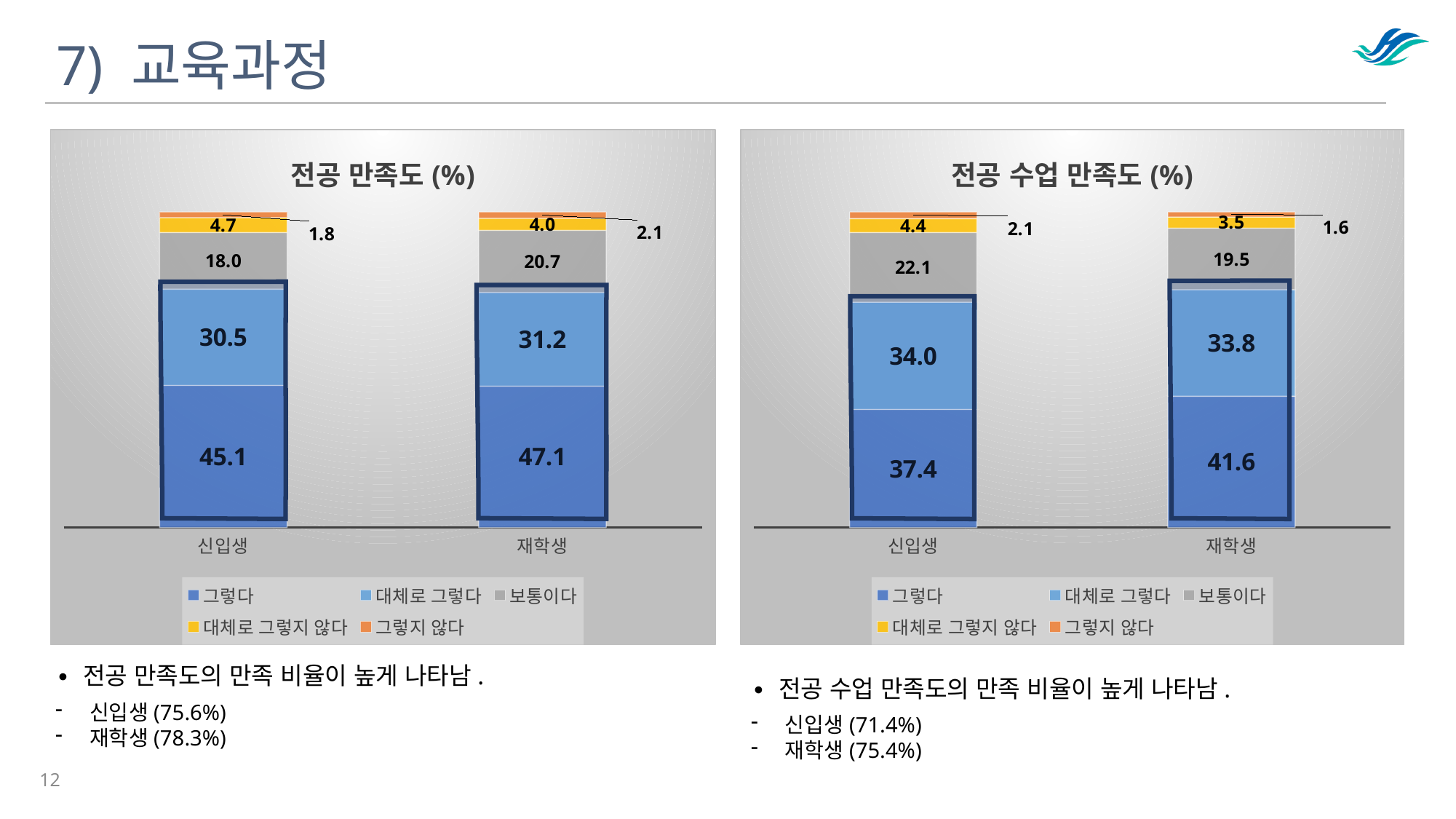
In the 전공 만족도 (%) chart, what is the value of 그렇다 for 신입생? 45.1 In the 전공 수업 만족도 (%) chart, which category has the higher 보통이다 value, 신입생 or 재학생? 신입생 In the 전공 수업 만족도 (%) chart, what is the value of 그렇지 않다 for 재학생? 1.6 How many categories are shown on the x axis of the 전공 만족도 (%) chart? 2 In the 전공 만족도 (%) chart, which category has the higher 그렇다 value, 신입생 or 재학생? 재학생 In the 전공 만족도 (%) chart, what is the difference between the 보통이다 values for 재학생 and 신입생? 2.7 How many series does the legend of the 전공 수업 만족도 (%) chart list? 5 In the 전공 수업 만족도 (%) chart, what is the value of 대체로 그렇다 for 신입생? 34.0 In the 전공 만족도 (%) chart, what is the value of 보통이다 for 재학생? 20.7 What kind of chart is the 전공 만족도 (%) chart? Stacked bar chart What is the title of the chart on the right side of the slide? 전공 수업 만족도 (%) In the 전공 수업 만족도 (%) chart, what is the difference between the 그렇다 values for 재학생 and 신입생? 4.2